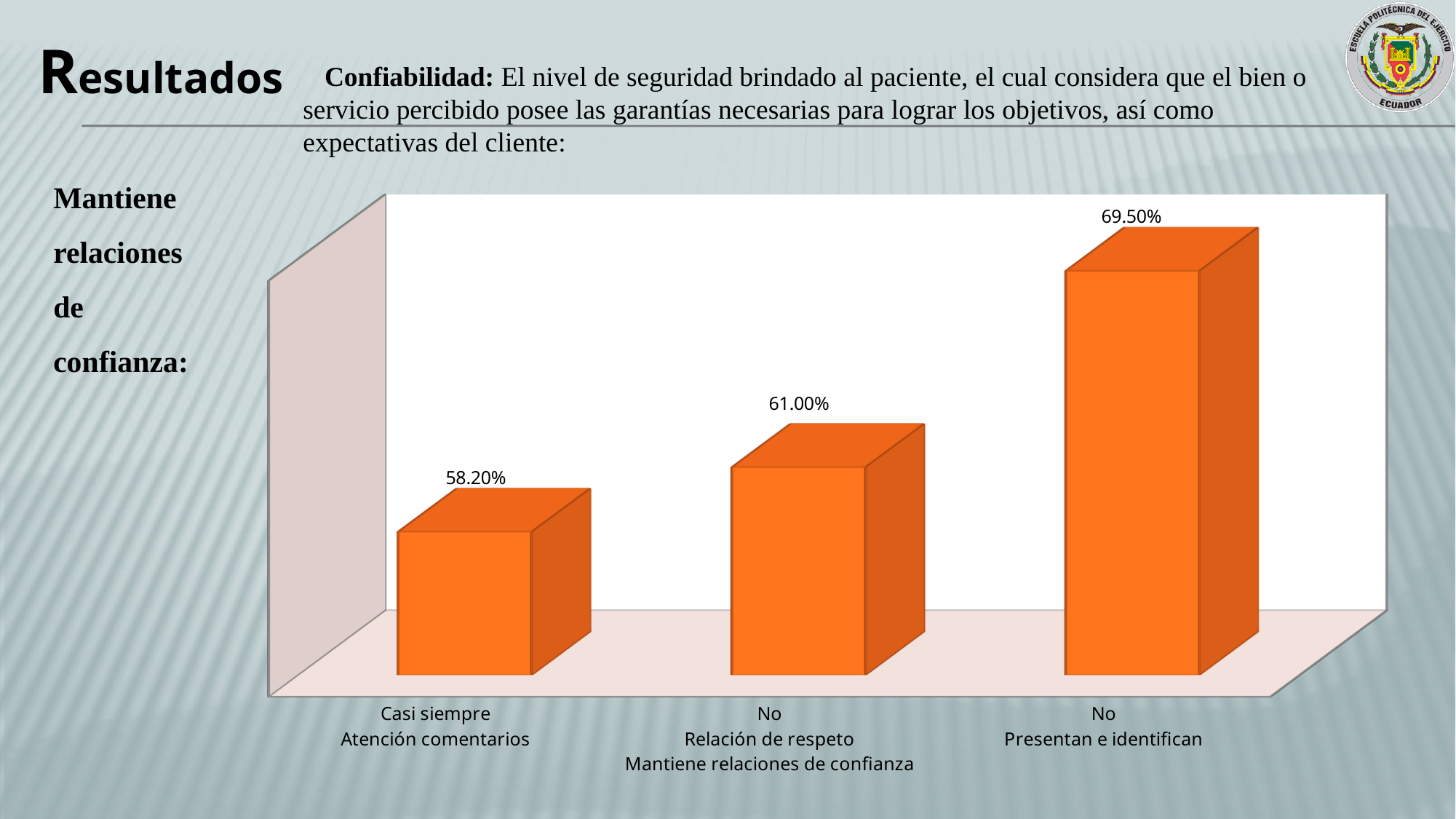
Which category has the highest value? Presentan e identifican What is the difference between the values for Presentan e identifican and Atención comentarios? 11.30% What is the value for Relación de respeto (No)? 61.00% Do the values rise or fall from left to right across the categories? Rise Which is larger, the value for Relación de respeto or the value for Presentan e identifican? Presentan e identifican What is the title shown below the category axis of the chart? Mantiene relaciones de confianza What is the value for Atención comentarios (Casi siempre)? 58.20% What kind of chart is shown on the slide? Bar chart How many bars are shown in the chart? 3 What is the value for Presentan e identifican (No)? 69.50% Which category has the lowest value? Atención comentarios What is the difference between the values for Relación de respeto and Atención comentarios? 2.80%